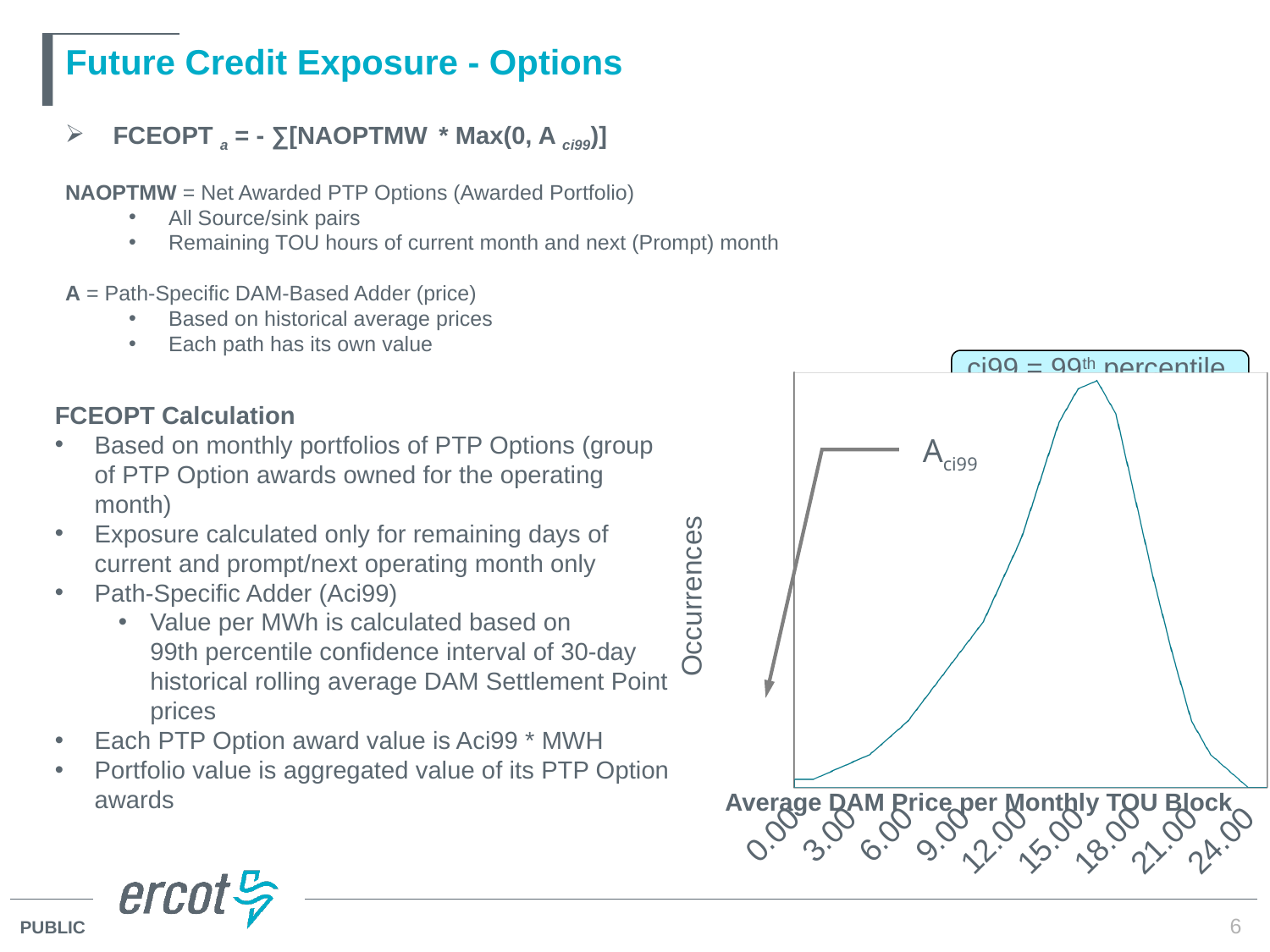
What is the label of the y axis of the chart? Occurrences What kind of chart is shown on the slide? line chart Does the curve rise or fall as the x axis goes from 18.00 to 24.00? fall Does the curve rise or fall as the x axis goes from 0.00 to 15.00? rise Which is larger on the chart, the number of occurrences at 18.00 or at 24.00? 18.00 What is the label of the x axis of the chart? Average DAM Price per Monthly TOU Block What is the lowest value shown on the x axis of the chart? 0.00 How many tick labels are shown on the x axis of the chart? 9 Which is larger on the chart, the number of occurrences at 15.00 or at 3.00? 15.00